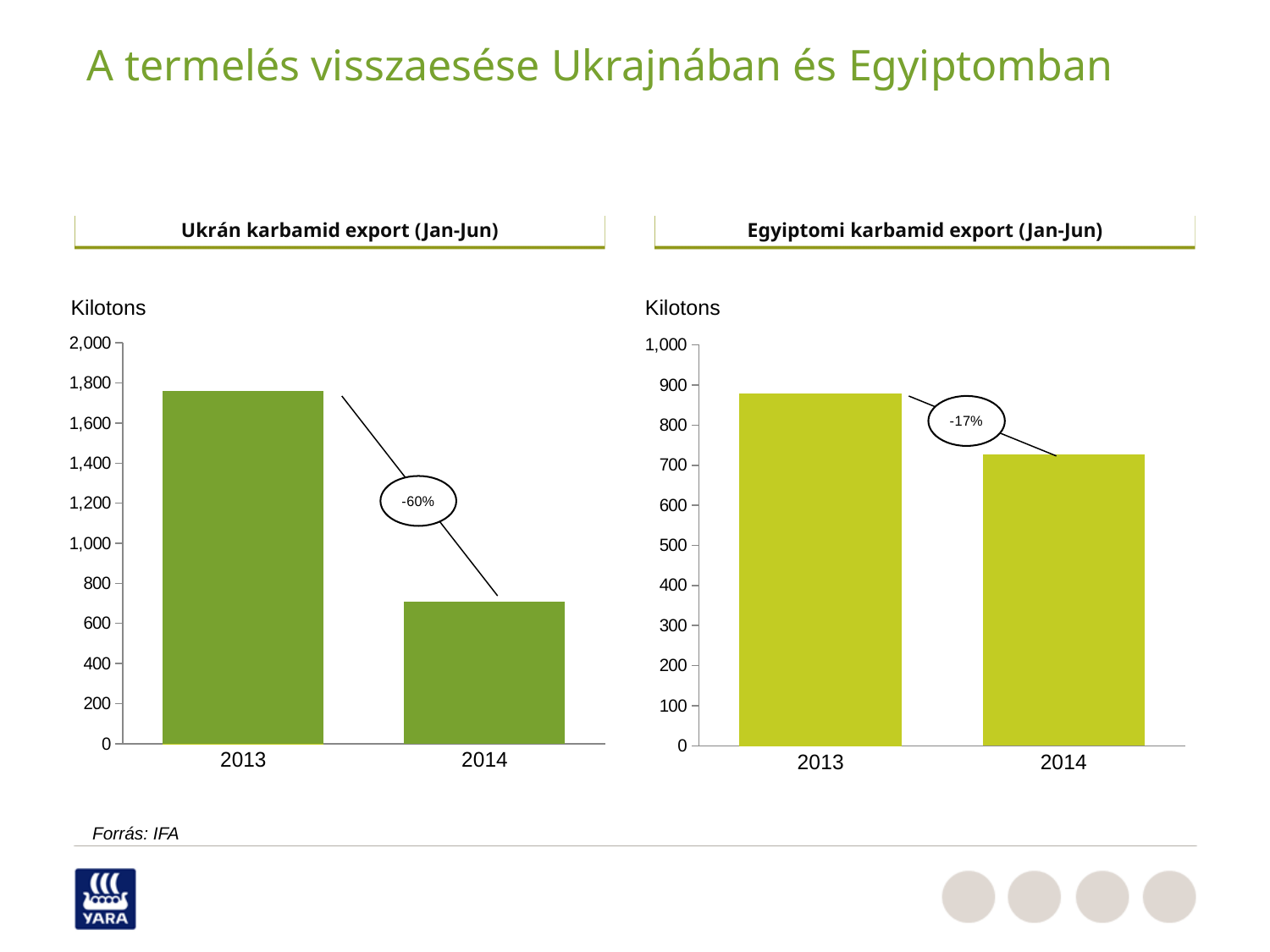
In the 'Ukrán karbamid export (Jan-Jun)' chart, what percentage change is annotated between 2013 and 2014? -60% How many bars are shown in the 'Ukrán karbamid export (Jan-Jun)' chart? 2 In the 'Egyiptomi karbamid export (Jan-Jun)' chart, what percentage change is annotated between 2013 and 2014? -17% What unit is shown on the y axis of the 'Ukrán karbamid export (Jan-Jun)' chart? Kilotons In the 'Ukrán karbamid export (Jan-Jun)' chart, is the value for 2014 greater or less than 800? less In the 'Egyiptomi karbamid export (Jan-Jun)' chart, is the value for 2014 greater or less than 800? less Do the values in the 'Egyiptomi karbamid export (Jan-Jun)' chart rise or fall from 2013 to 2014? fall What kind of chart is the 'Ukrán karbamid export (Jan-Jun)' chart? bar chart In the 'Ukrán karbamid export (Jan-Jun)' chart, is the value for 2013 greater or less than 1,600? greater In the 'Ukrán karbamid export (Jan-Jun)' chart, which year has the higher value? 2013 In the 'Egyiptomi karbamid export (Jan-Jun)' chart, which year has the lower value? 2014